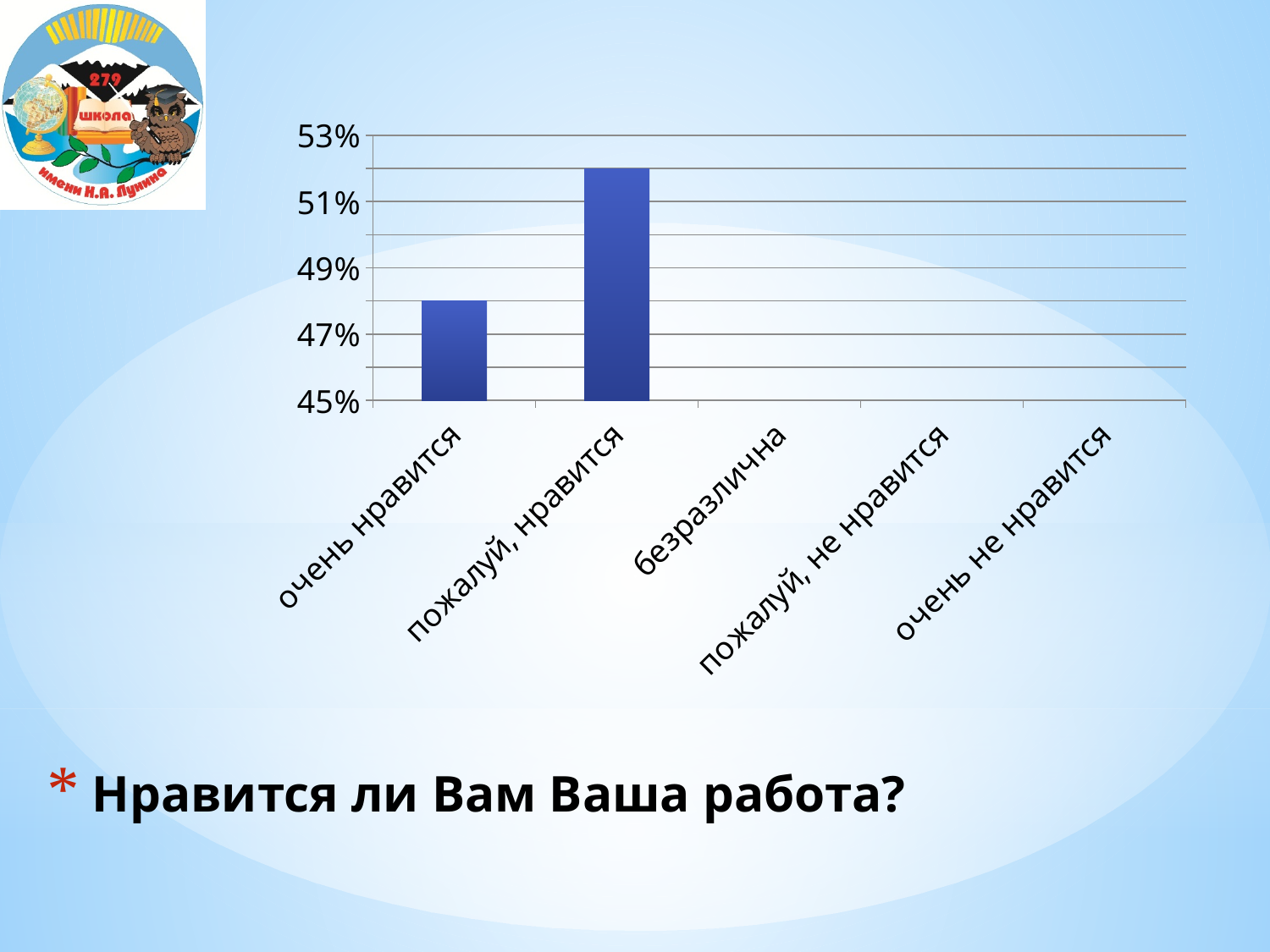
Is the value for "пожалуй, нравится" greater or less than 51%? greater What is the label of the last category on the x axis? очень не нравится How many categories are shown on the x axis of the chart? 5 Is the value for "очень нравится" greater or less than 47%? greater What question is written in bold text below the chart? Нравится ли Вам Ваша работа? Which category has the highest bar in the chart? пожалуй, нравится What kind of chart is shown on the slide? bar chart Which is larger, the value for "очень нравится" or the value for "пожалуй, нравится"? пожалуй, нравится Is the value for "очень нравится" greater or less than 49%? less What is the lowest value labelled on the vertical axis of the chart? 45% What is the label of the first category on the x axis? очень нравится